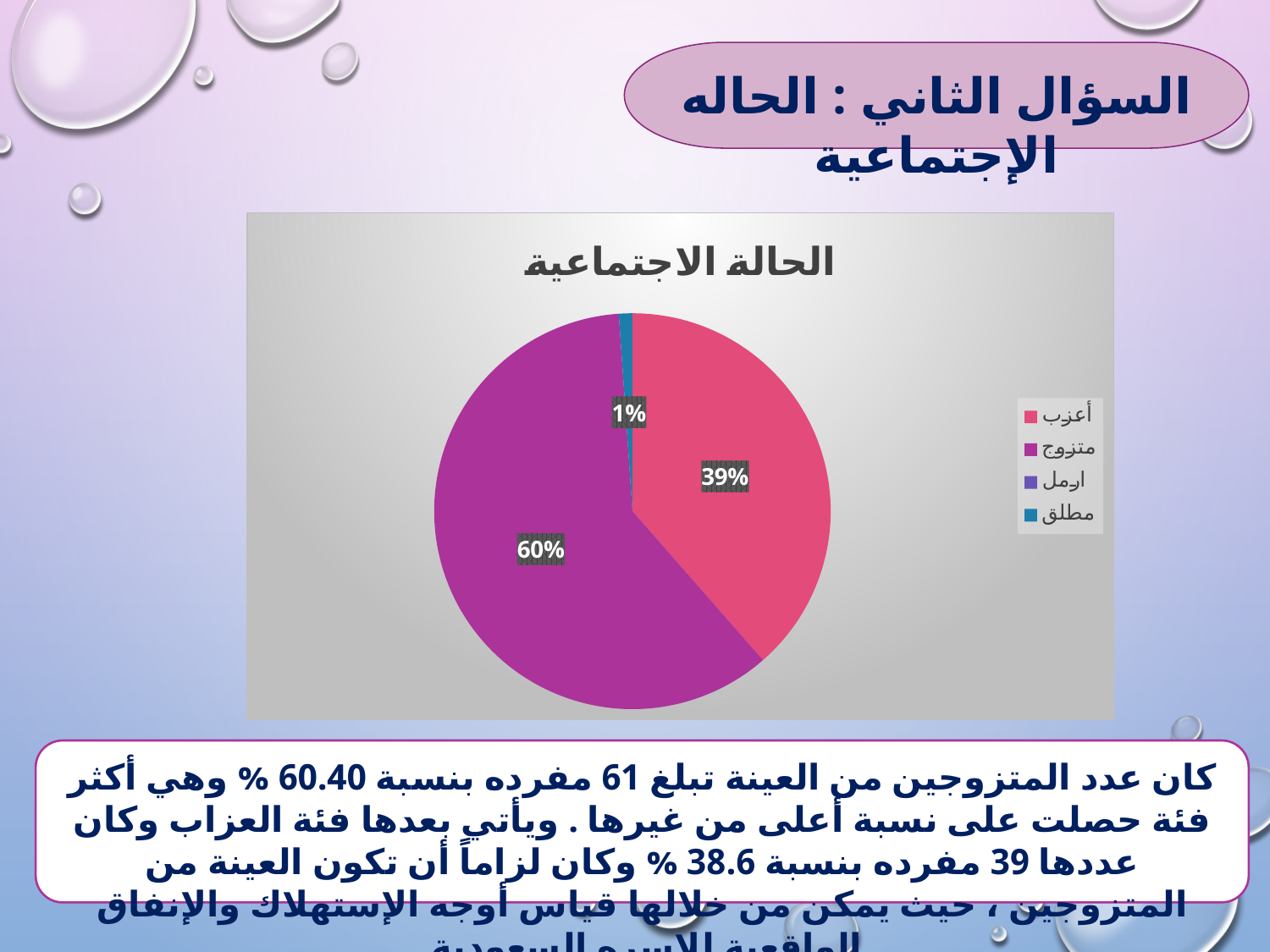
What percentage does the متزوج slice show in the pie chart? 60% What is the title of the chart? الحالة الاجتماعية What percentage does the أعزب slice show in the pie chart? 39% What colour is used for the متزوج slice in the pie chart? Purple Of the slices with a printed percentage, which is the smallest? مطلق Is the share for متزوج greater or less than 50%? greater What kind of chart is shown on the slide? Pie chart Which is larger in the pie chart, the أعزب slice or the متزوج slice? متزوج What percentage does the مطلق slice show in the pie chart? 1% By how many percentage points does the متزوج slice exceed the أعزب slice? 21 percentage points Which category has the largest slice in the pie chart? متزوج How many entries does the legend of the pie chart list? 4